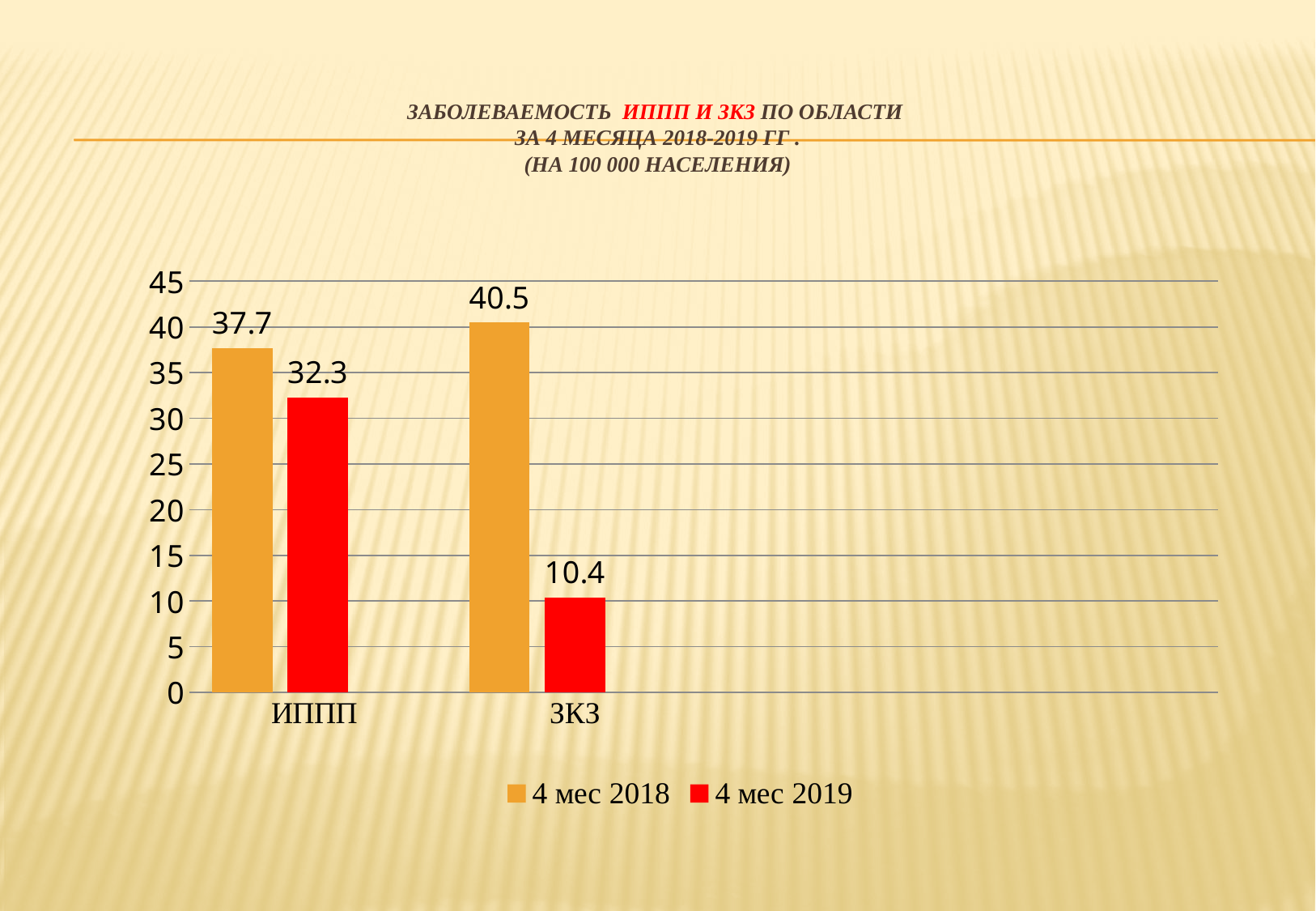
What kind of chart is shown on the slide? Bar chart Which is larger: the 4 мес 2018 value for ИППП or the 4 мес 2018 value for ЗКЗ? ЗКЗ How many series does the legend list? 2 Which category has the highest value in the 4 мес 2018 series? ЗКЗ What is the difference between the 4 мес 2018 and 4 мес 2019 values for ИППП? 5.4 What is the value for ЗКЗ in the 4 мес 2018 series? 40.5 What is the value for ИППП in the 4 мес 2018 series? 37.7 Which category has the lowest value in the 4 мес 2019 series? ЗКЗ How many categories are shown on the x axis? 2 What is the value for ЗКЗ in the 4 мес 2019 series? 10.4 What is the value for ИППП in the 4 мес 2019 series? 32.3 What is the difference between the 4 мес 2018 and 4 мес 2019 values for ЗКЗ? 30.1